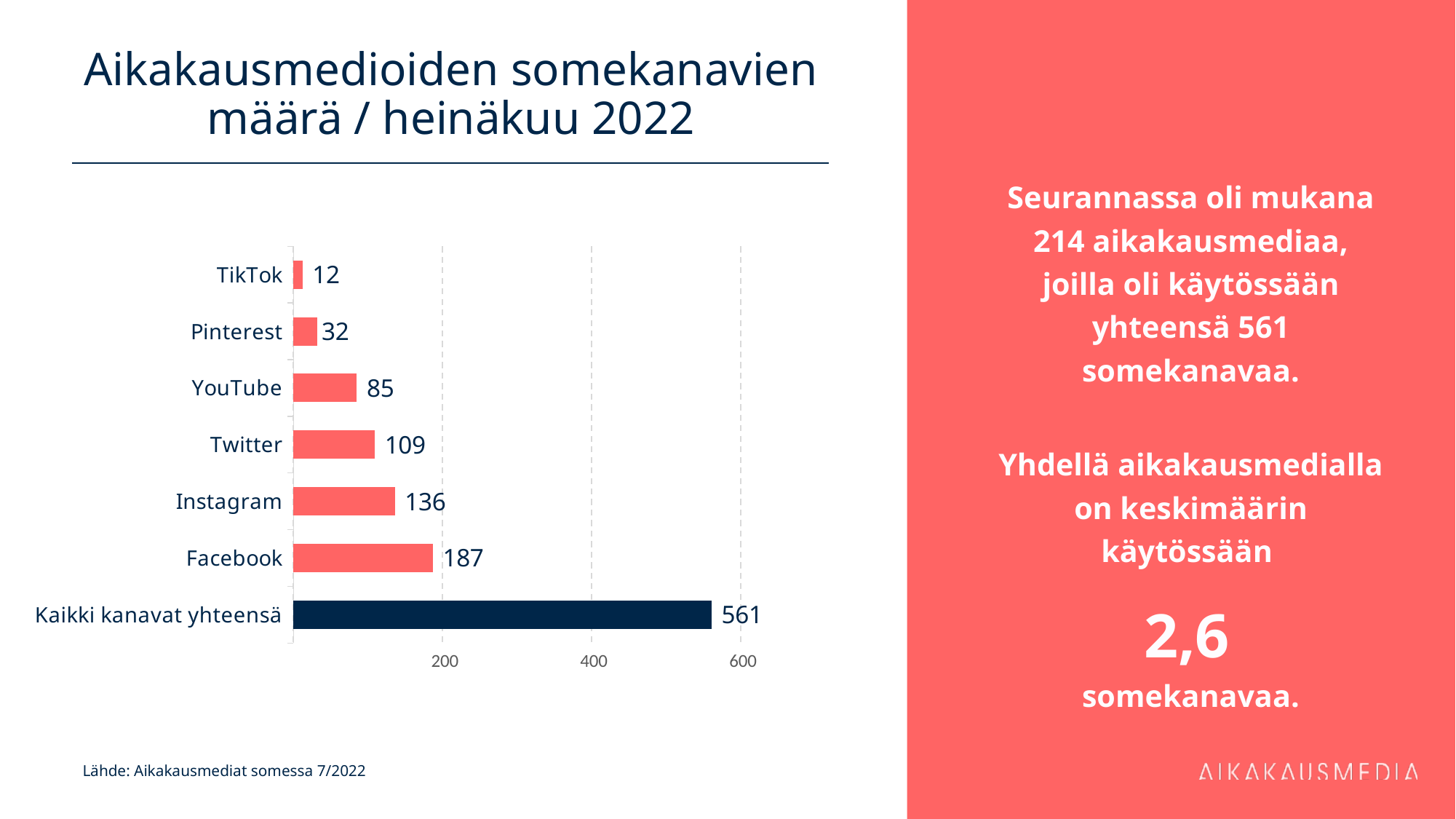
What kind of chart is shown on the slide? Bar chart What is the title of the chart on the slide? Aikakausmedioiden somekanavien määrä / heinäkuu 2022 How many categories are shown in the chart? 7 What is the value for Kaikki kanavat yhteensä? 561 Which has a larger value, Pinterest or YouTube? YouTube What is the difference between the values for Twitter and YouTube? 24 What is the value for TikTok? 12 What is the value for Facebook? 187 What is the value for Instagram? 136 Which individual social media channel has the highest value? Facebook Which category has the lowest value? TikTok What is the difference between the values for Facebook and Instagram? 51